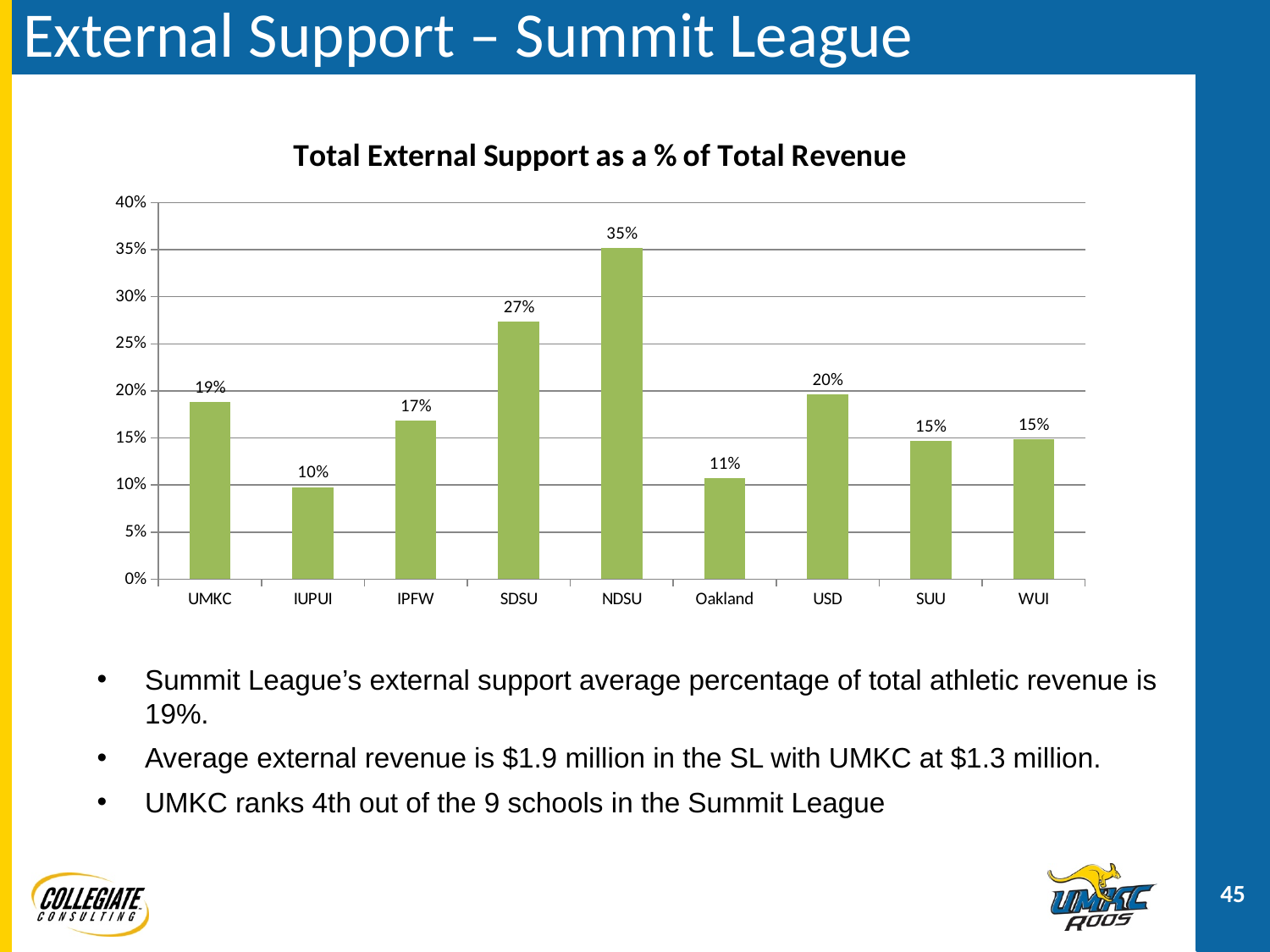
What is the difference between the values for USD and IUPUI? 10% Which school has the lowest total external support as a % of total revenue? IUPUI What is the value for UMKC? 19% Which is larger, the value for IPFW or the value for USD? USD Is the value for SDSU greater or less than 25%? greater How many schools are shown on the chart? 9 What is the title of the chart? Total External Support as a % of Total Revenue What is the difference between the values for NDSU and SDSU? 8% Which school has the highest total external support as a % of total revenue? NDSU What is the value for Oakland? 11% What kind of chart is shown on the slide? Bar chart What is the value for NDSU? 35%